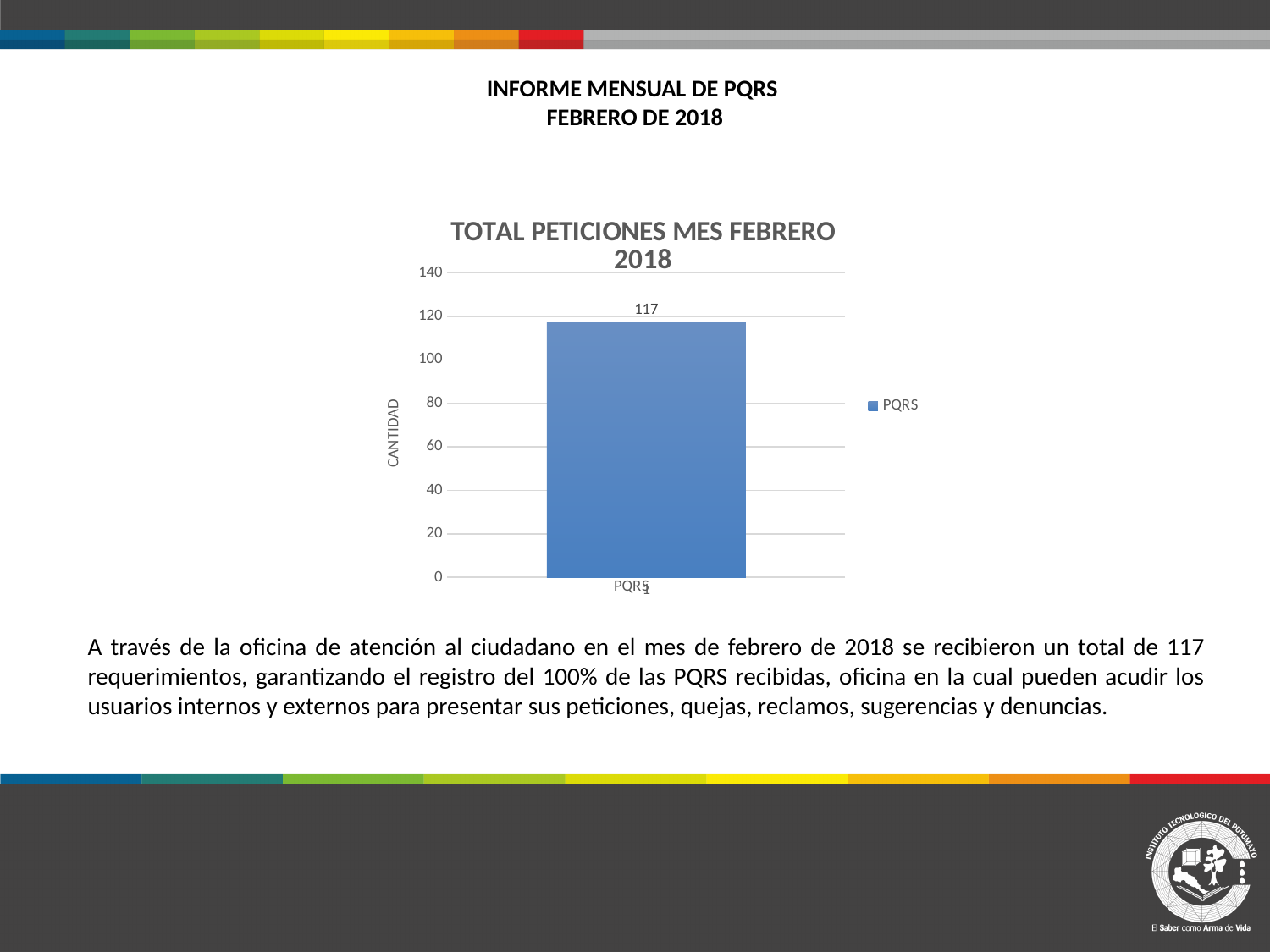
Is the value for PQRS greater or less than 100? greater How many series does the chart legend list? 1 What is the highest value shown on the vertical axis of the chart? 140 What is the value of the PQRS bar in the chart? 117 How many bars does the chart show? 1 What kind of chart is shown on the slide? bar chart Is the value for PQRS greater or less than 120? less What is the label on the vertical axis of the chart? CANTIDAD What is the title of the chart? TOTAL PETICIONES MES FEBRERO 2018